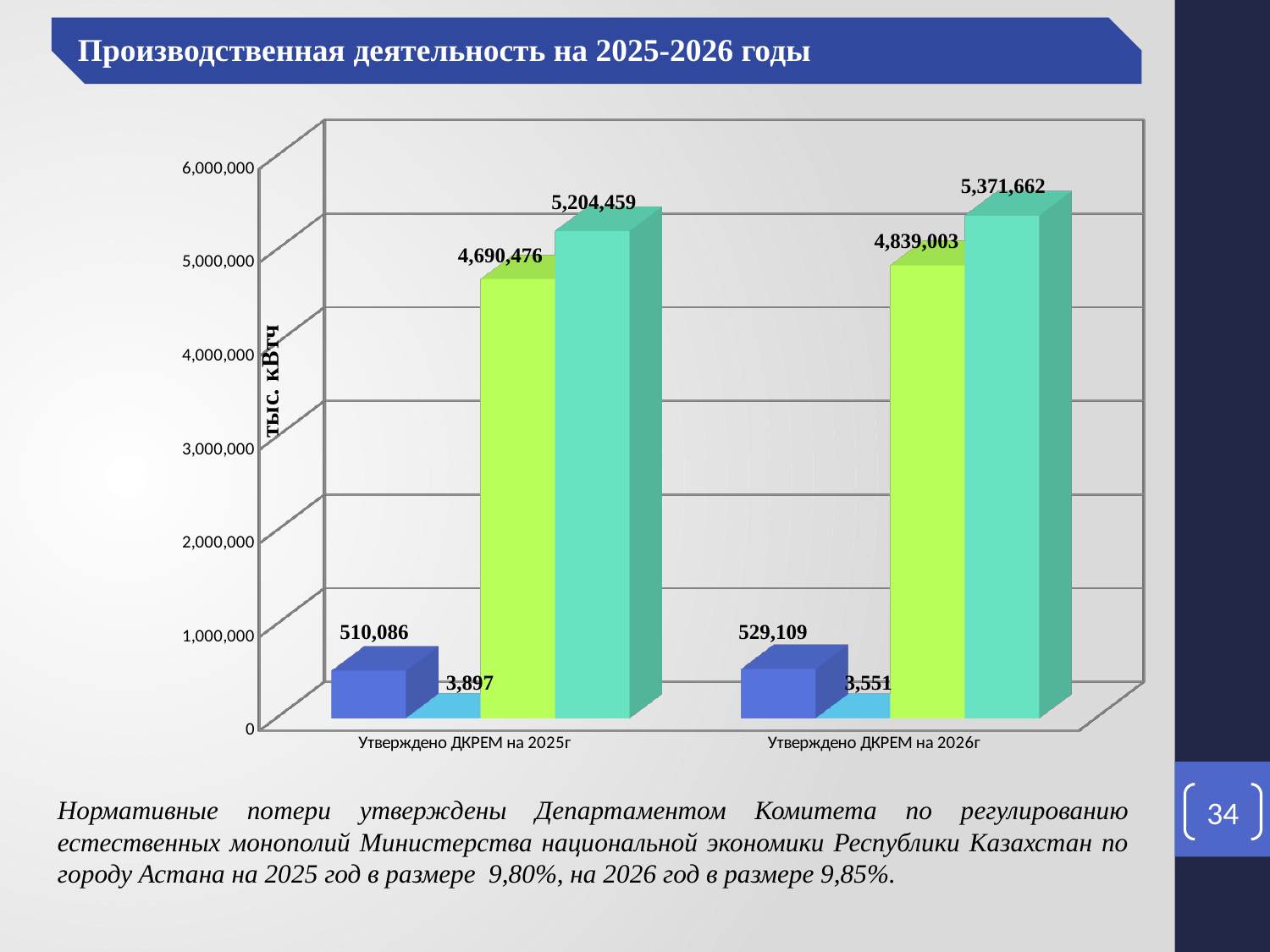
What is the difference between the green bar values for 2026 (4,839,003) and 2025 (4,690,476)? 148,527 What is the value of the blue bar for 'Утверждено ДКРЕМ на 2025г'? 510,086 What is the value of the smallest (cyan) bar for 'Утверждено ДКРЕМ на 2026г'? 3,551 Which is larger: the blue bar for 'Утверждено ДКРЕМ на 2025г' or the blue bar for 'Утверждено ДКРЕМ на 2026г'? Утверждено ДКРЕМ на 2026г (529,109) Which bar has the lowest value on the chart? 3,551 (cyan bar, Утверждено ДКРЕМ на 2026г) What is the label of the vertical axis? тыс. кВтч What is the value of the tallest (teal) bar for 'Утверждено ДКРЕМ на 2025г'? 5,204,459 What is the difference between the teal bar values for 2026 (5,371,662) and 2025 (5,204,459)? 167,203 What is the value of the green bar for 'Утверждено ДКРЕМ на 2026г'? 4,839,003 Which bar has the highest value on the chart? 5,371,662 (teal bar, Утверждено ДКРЕМ на 2026г) What type of chart is shown on the slide? bar chart How many categories are shown on the x axis? 2